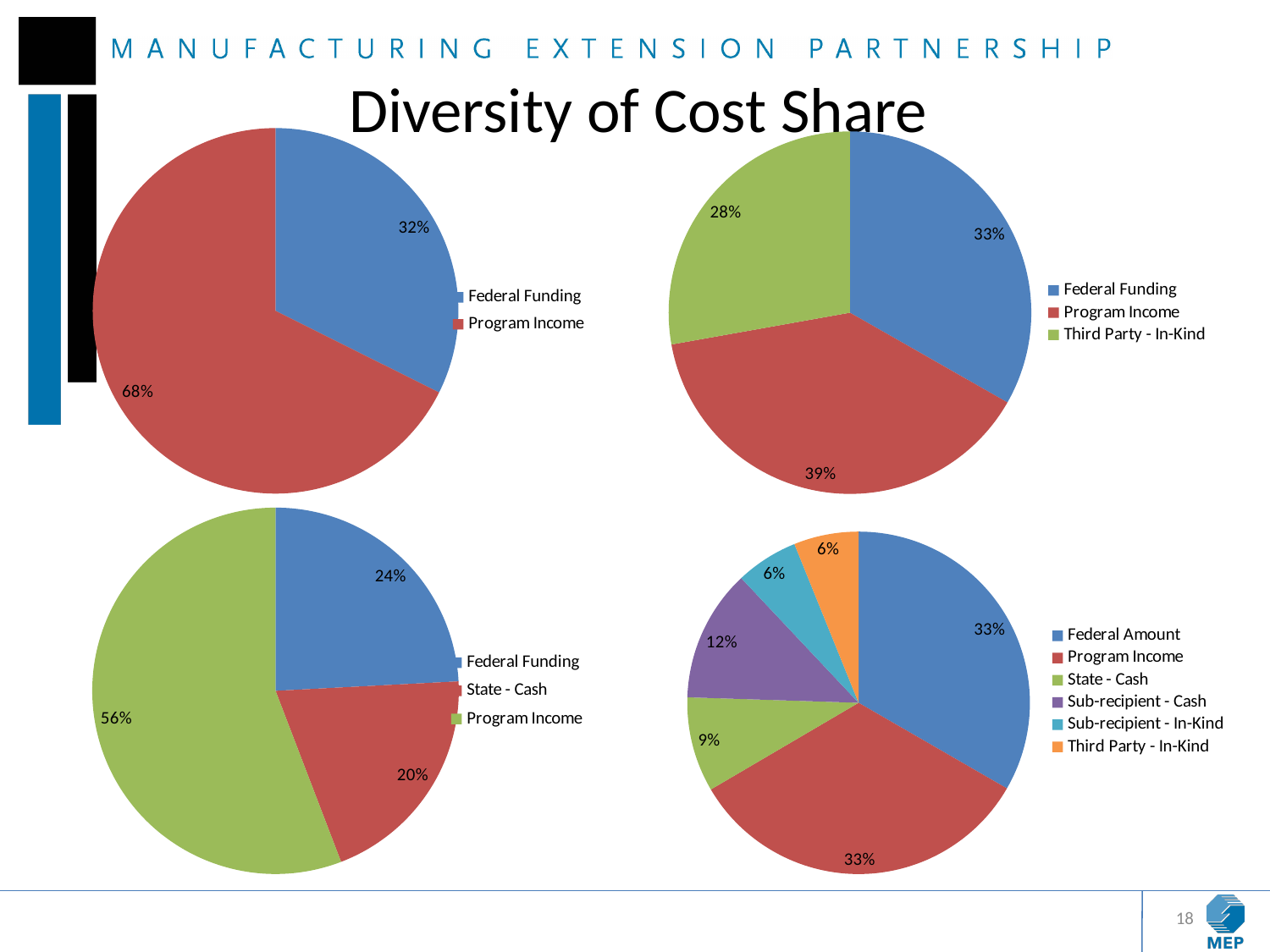
In the top-right pie chart, what is the difference between the Program Income share and the Third Party - In-Kind share? 11% In the top-right pie chart, what share is Third Party - In-Kind? 28% In the bottom-left pie chart, what share is State - Cash? 20% How many categories does the legend of the bottom-right pie chart list? 6 In the bottom-left pie chart, which category has the smallest share? State - Cash In the top-left pie chart, what share is Program Income? 68% In the top-right pie chart, which category has the largest share? Program Income In the bottom-left pie chart, which is larger, Federal Funding or Program Income? Program Income What type of chart is the top-left chart? Pie chart